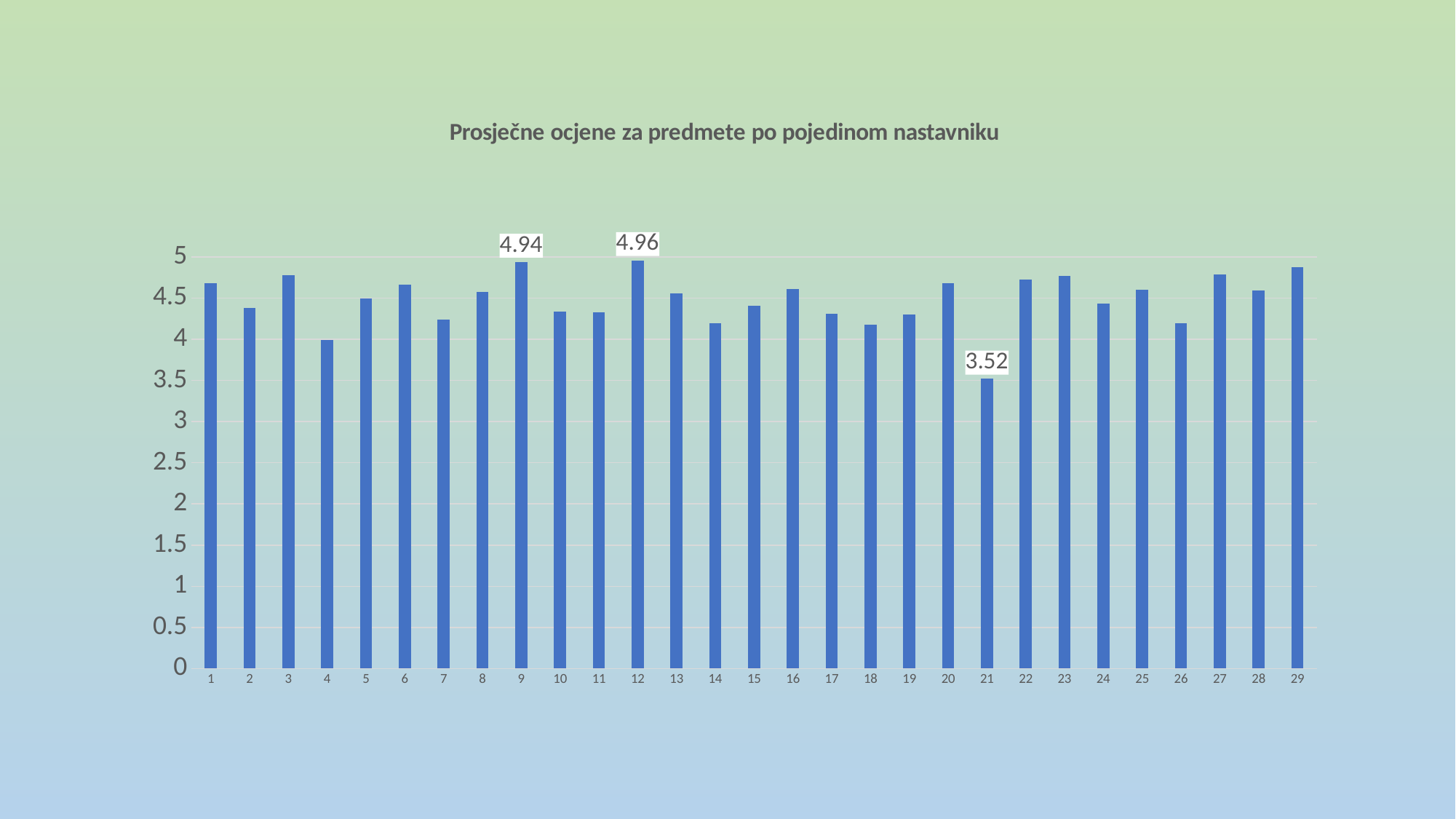
Which is larger, the value for category 9 or category 21? 9 What is the value for category 21? 3.52 Is the value for category 3 greater or less than 4.5? greater How many categories are shown on the x axis? 29 What type of chart is shown on the slide? bar chart What is the difference between the values for category 12 and category 9? 0.02 Which category has the lowest value? 21 What is the value for category 9? 4.94 Is the value for category 14 greater or less than 4.5? less Which category has the highest value? 12 What is the value for category 12? 4.96 What is the difference between the values for category 12 and category 21? 1.44